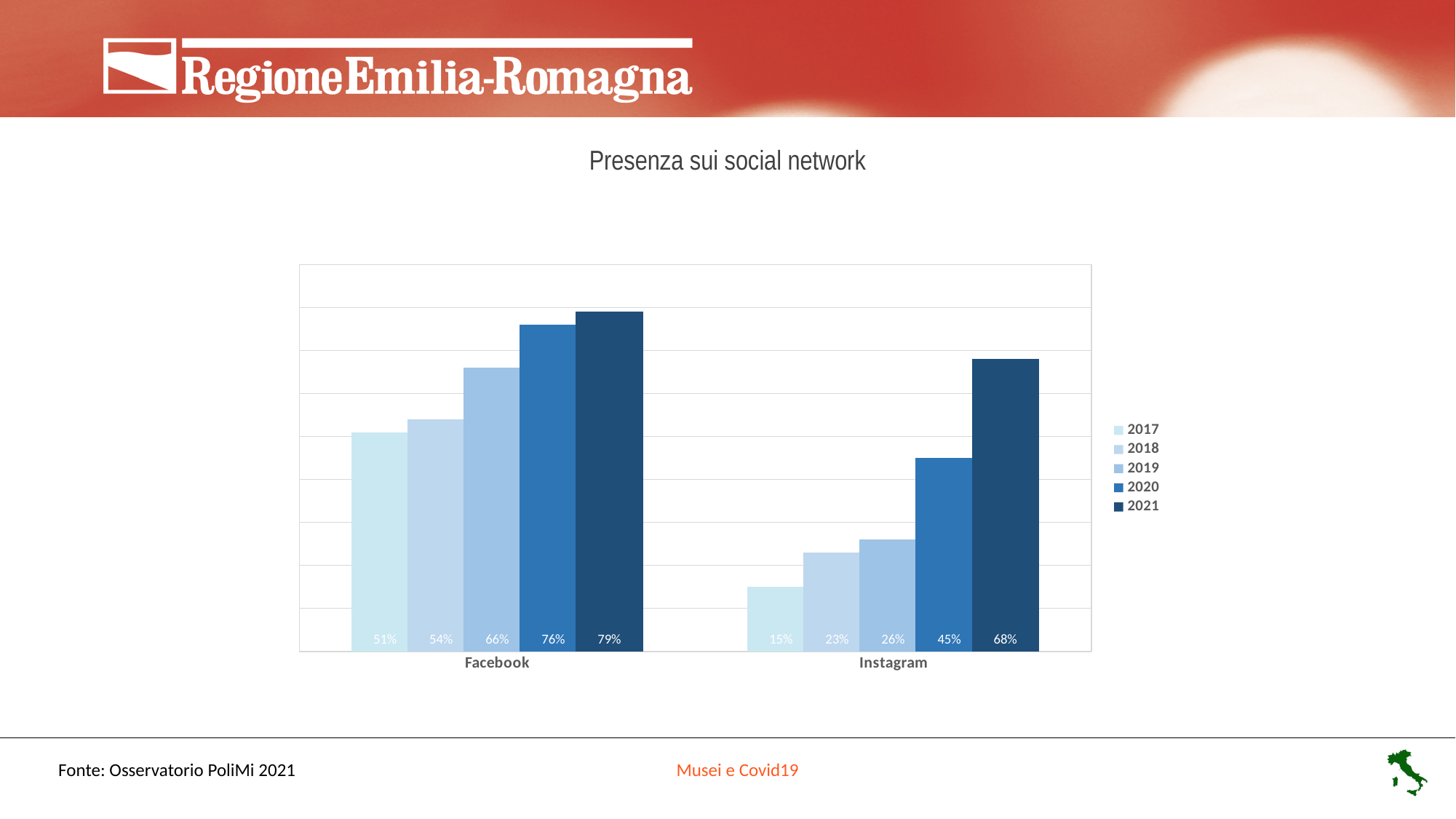
Which year has the lowest value for Facebook? 2017 What is the value for Instagram in 2020? 45% What kind of chart is shown on the slide? Bar chart What is the difference between the Facebook and Instagram values in 2021? 11% What is the value for Instagram in 2017? 15% Which year has the highest value for Instagram? 2021 How many series does the legend list? 5 What is the value for Facebook in 2019? 66% What is the value for Facebook in 2021? 79% What is the difference between the Instagram values in 2021 and 2020? 23% Which is larger, the Facebook value in 2018 or the Instagram value in 2021? Instagram in 2021 Do the Facebook values rise or fall from 2017 to 2021? Rise